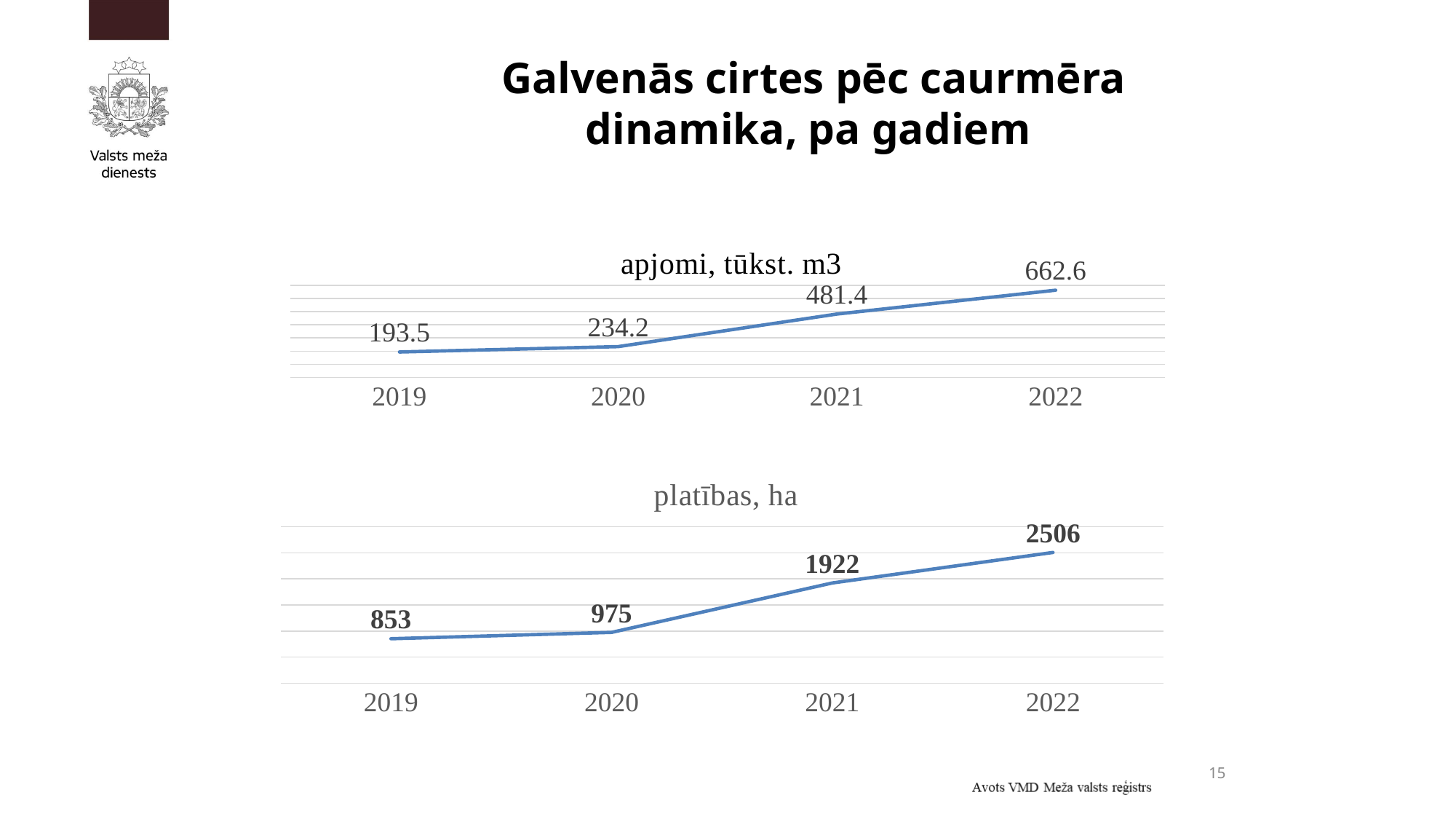
What kind of chart is the chart titled "platības, ha"? line chart How many years are plotted in the chart titled "apjomi, tūkst. m3"? 4 In the chart titled "apjomi, tūkst. m3", which year has the highest value? 2022 In the chart titled "platības, ha", what is the value for 2020? 975 In the chart titled "apjomi, tūkst. m3", do the values rise or fall from 2019 to 2022? rise What is the title of the upper chart on the slide? apjomi, tūkst. m3 In the chart titled "platības, ha", what is the value for 2022? 2506 In the chart titled "apjomi, tūkst. m3", what is the value for 2021? 481.4 In the chart titled "apjomi, tūkst. m3", what is the difference between the 2022 and 2019 values? 469.1 In the chart titled "platības, ha", which year has the lowest value? 2019 In the chart titled "platības, ha", which is larger, the value for 2021 or the value for 2022? 2022 In the chart titled "platības, ha", what is the difference between the 2021 and 2020 values? 947